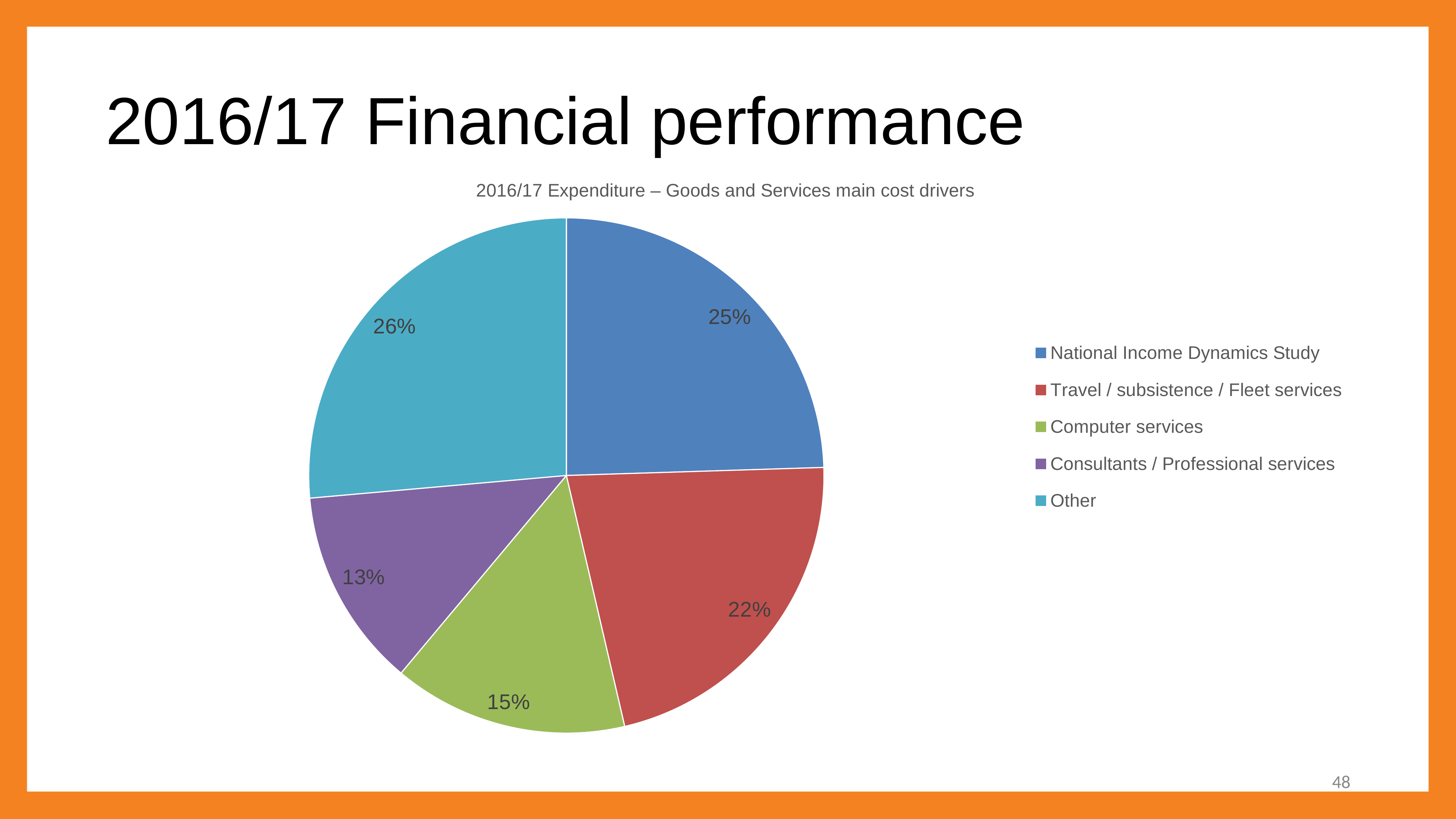
What share of the pie is labelled Other? 26% Which category has the smallest share of the pie? Consultants / Professional services What kind of chart is shown on the slide? Pie chart What is the difference in percentage points between the National Income Dynamics Study share and the Computer services share? 10 How many categories does the pie chart show? 5 Which is larger: the share for Travel / subsistence / Fleet services or the share for Consultants / Professional services? Travel / subsistence / Fleet services What is the title of the chart? 2016/17 Expenditure – Goods and Services main cost drivers What percentage of the pie is Travel / subsistence / Fleet services? 22% What share does Computer services account for? 15% What percentage is shown for Consultants / Professional services? 13% What share of 2016/17 Goods and Services expenditure is attributed to the National Income Dynamics Study? 25% Which category has the largest share of the pie? Other